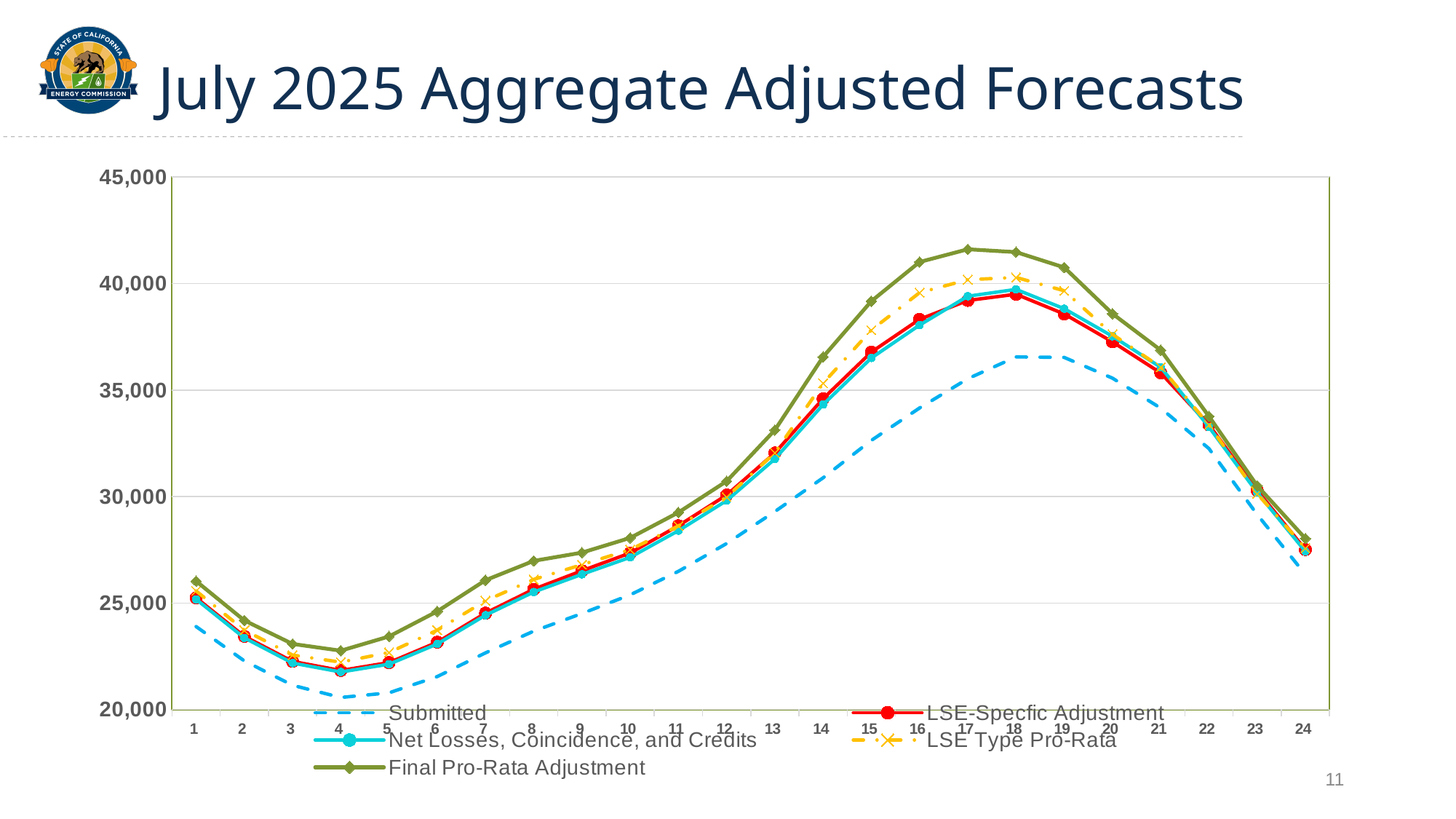
Is the value for LSE-Specfic Adjustment at hour 13 greater or less than 30,000? greater Does the Final Pro-Rata Adjustment series rise or fall from hour 4 to hour 17? Rise Is the value for Submitted at hour 4 greater or less than 25,000? less Which series has the lowest value at hour 4? Submitted How many series does the legend list? 5 How many points are plotted along the x axis for each series? 24 What kind of chart is shown on the slide? Line chart Is the value for Final Pro-Rata Adjustment at hour 17 greater or less than 40,000? greater At hour 17, which is larger: Final Pro-Rata Adjustment or Submitted? Final Pro-Rata Adjustment Which series has the highest value at hour 17? Final Pro-Rata Adjustment What is the title of the slide? July 2025 Aggregate Adjusted Forecasts